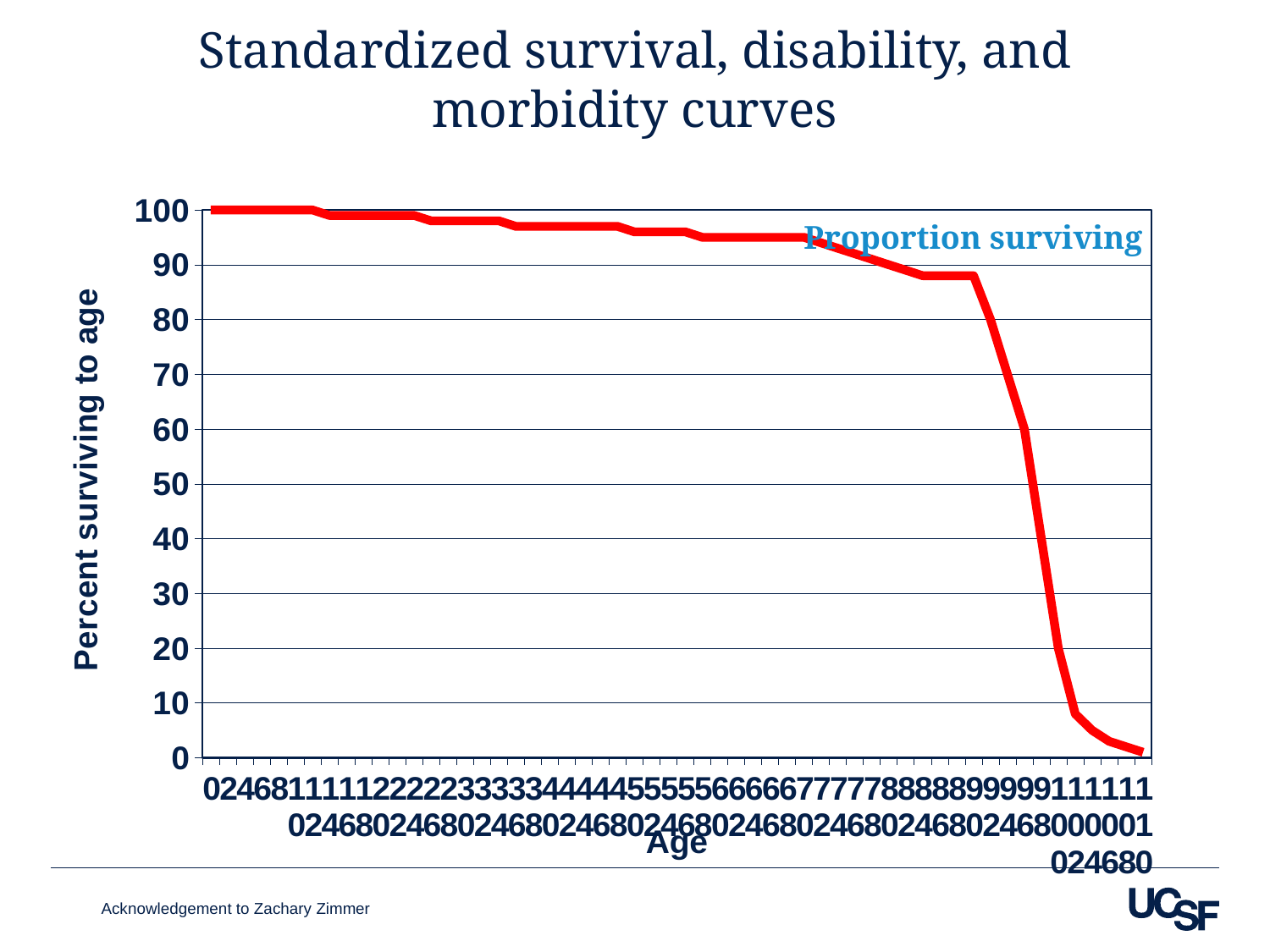
What is the name of the series plotted on the chart? Proportion surviving At which end of the x axis does the line reach its lowest value? the right end Does the plotted line rise or fall as age increases along the x axis? fall What is the title of the y axis? Percent surviving to age Is the value of the line at the middle of the x axis greater or less than 100? less How many lines are plotted on the chart? 1 What kind of chart is shown on the slide? line chart Is the value at the leftmost point of the line greater or less than 90? greater Which is larger, the value at the left end of the line or the value at the right end? the left end At which end of the x axis does the line reach its highest value? the left end Is the value of the line at the middle of the x axis greater or less than 80? greater